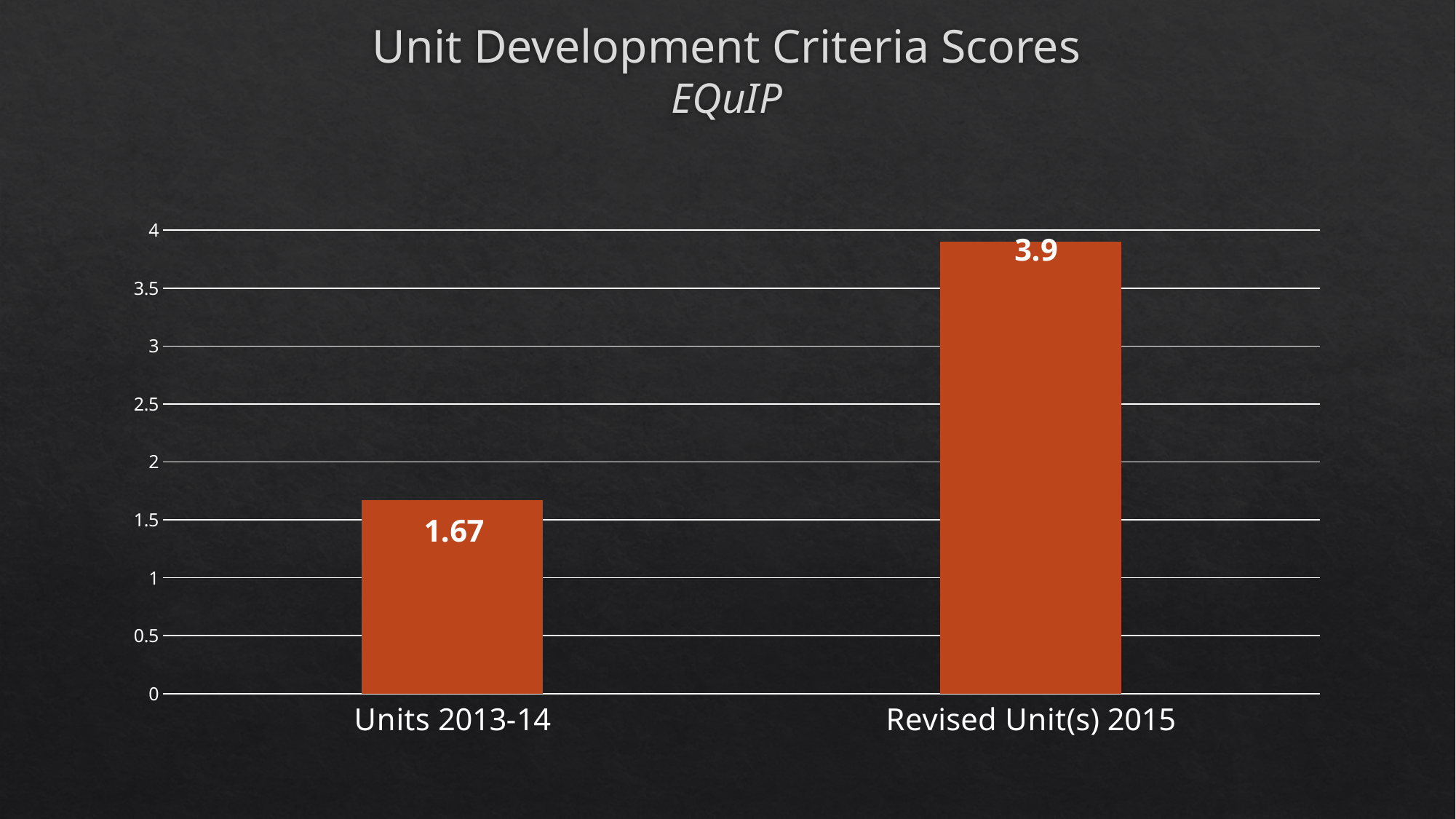
Do the values rise or fall from Units 2013-14 to Revised Unit(s) 2015? rise Which category has the highest value? Revised Unit(s) 2015 How many categories are shown on the x axis? 2 Is the value for Units 2013-14 greater or less than 2? less What is the value for Revised Unit(s) 2015? 3.9 Which is larger, the value for Units 2013-14 or the value for Revised Unit(s) 2015? Revised Unit(s) 2015 Is the value for Revised Unit(s) 2015 greater or less than 3.5? greater What is the difference between the values for Revised Unit(s) 2015 and Units 2013-14? 2.23 Which category has the lowest value? Units 2013-14 What kind of chart is shown on the slide? bar chart What is the value for Units 2013-14? 1.67 What is the title of the chart? Unit Development Criteria Scores EQuIP